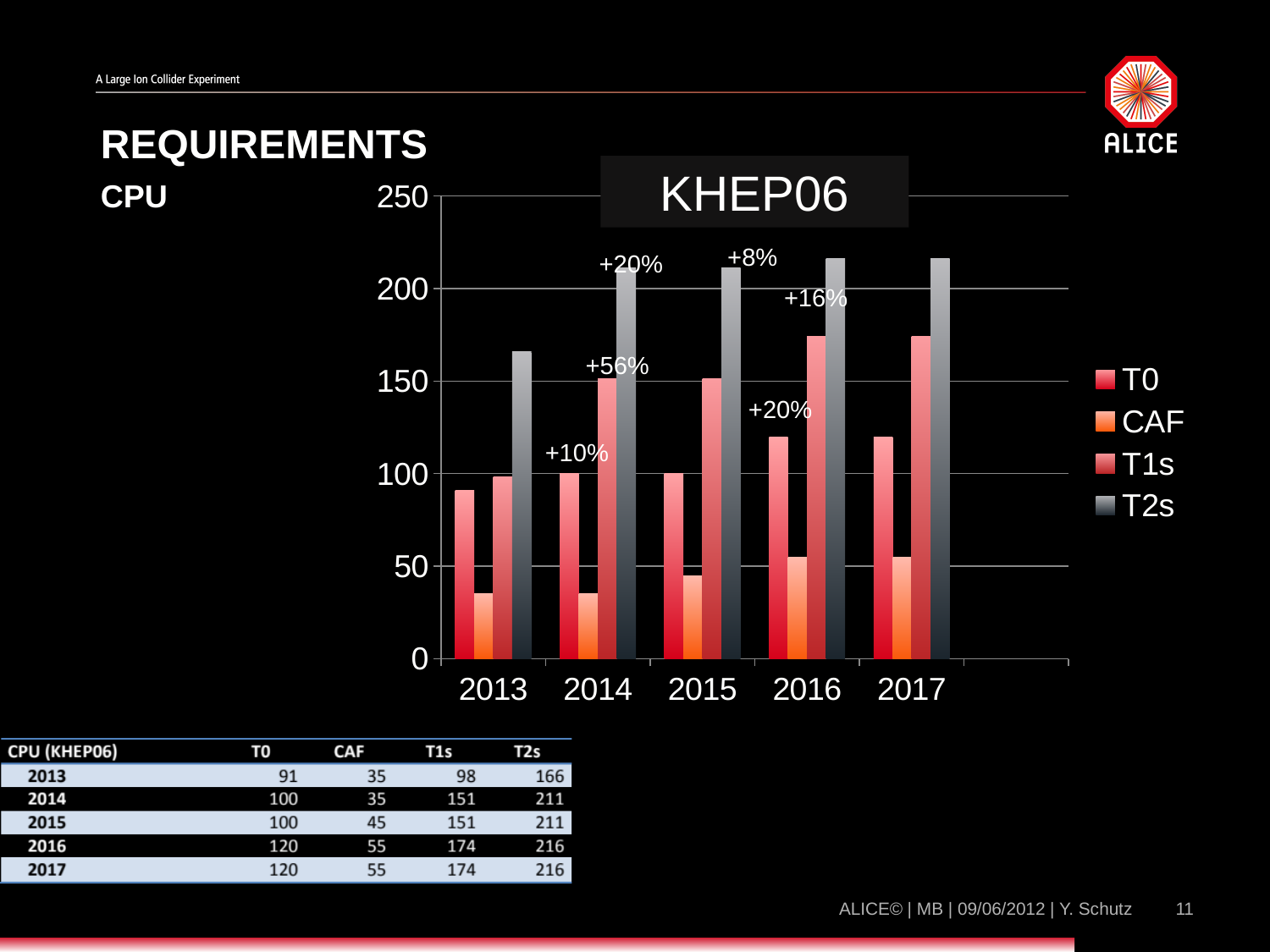
Does the T1s value rise or fall from 2013 to 2017? rise According to the table, what is the T1s value for 2016? 174 How many years are shown on the x axis of the chart? 5 Which series has the lowest value in 2017? CAF What kind of chart is shown on the slide? bar chart What is the difference between the T2s value in 2014 and the T2s value in 2013? 45 According to the table, what is the T2s value for 2013? 166 How many series does the chart legend list? 4 Is the T0 value for 2016 larger or smaller than the T0 value for 2013? larger What is the title of the chart? KHEP06 Which series has the highest value in 2014? T2s According to the table, what is the CAF value for 2015? 45